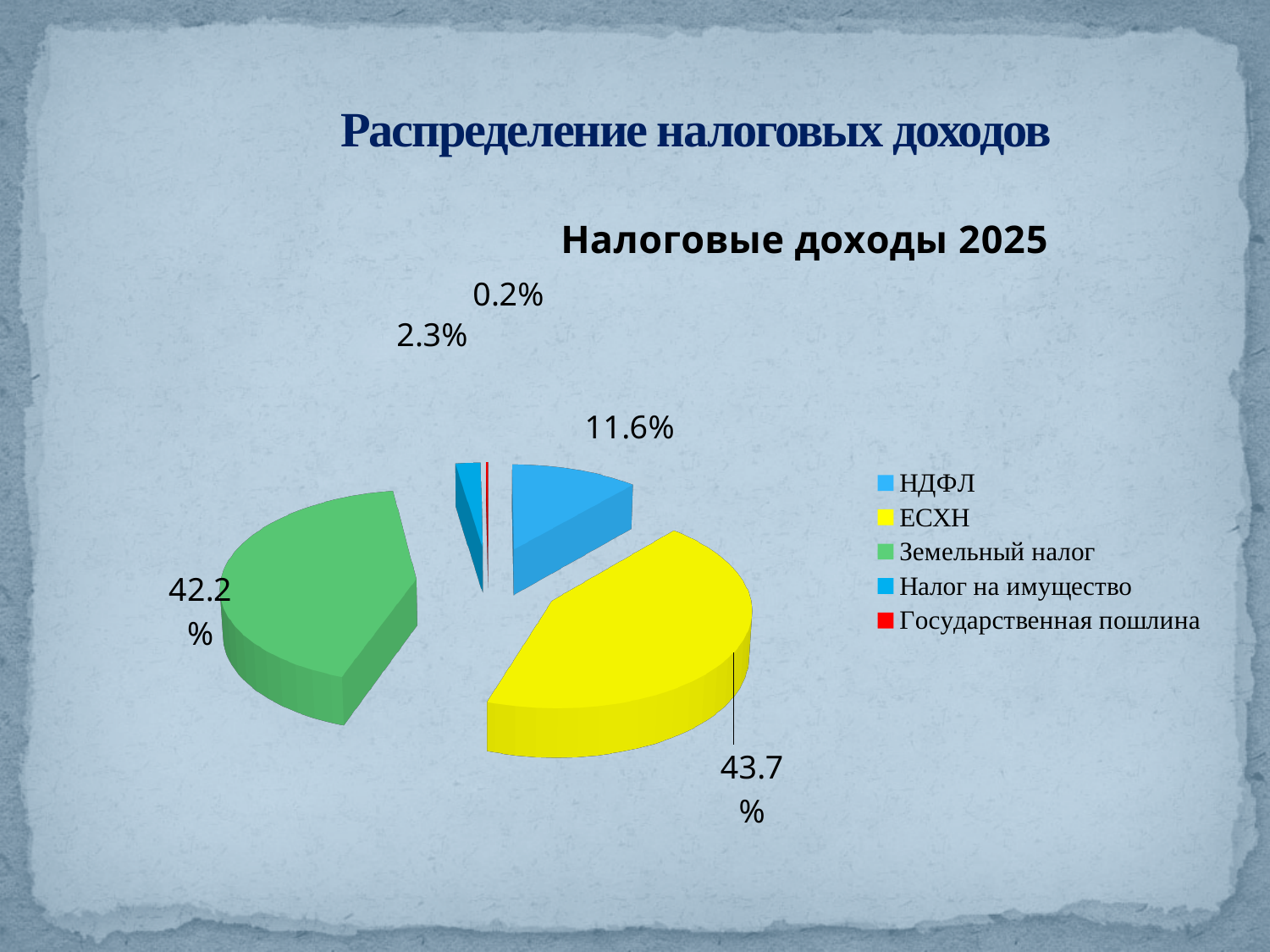
Which category has the largest share of the pie? ЕСХН What is the difference between the shares of ЕСХН and Земельный налог? 1.5% What type of chart is shown on the slide? pie chart What share of the pie does Государственная пошлина have? 0.2% Which category has the smallest share of the pie? Государственная пошлина What share of the pie does НДФЛ have? 11.6% What share of the pie does Налог на имущество have? 2.3% Which is larger, the share of НДФЛ or the share of Налог на имущество? НДФЛ How many categories does the legend of the chart list? 5 What is the title of the chart? Налоговые доходы 2025 What share of the pie does Земельный налог have? 42.2% What share of the pie does ЕСХН have? 43.7%